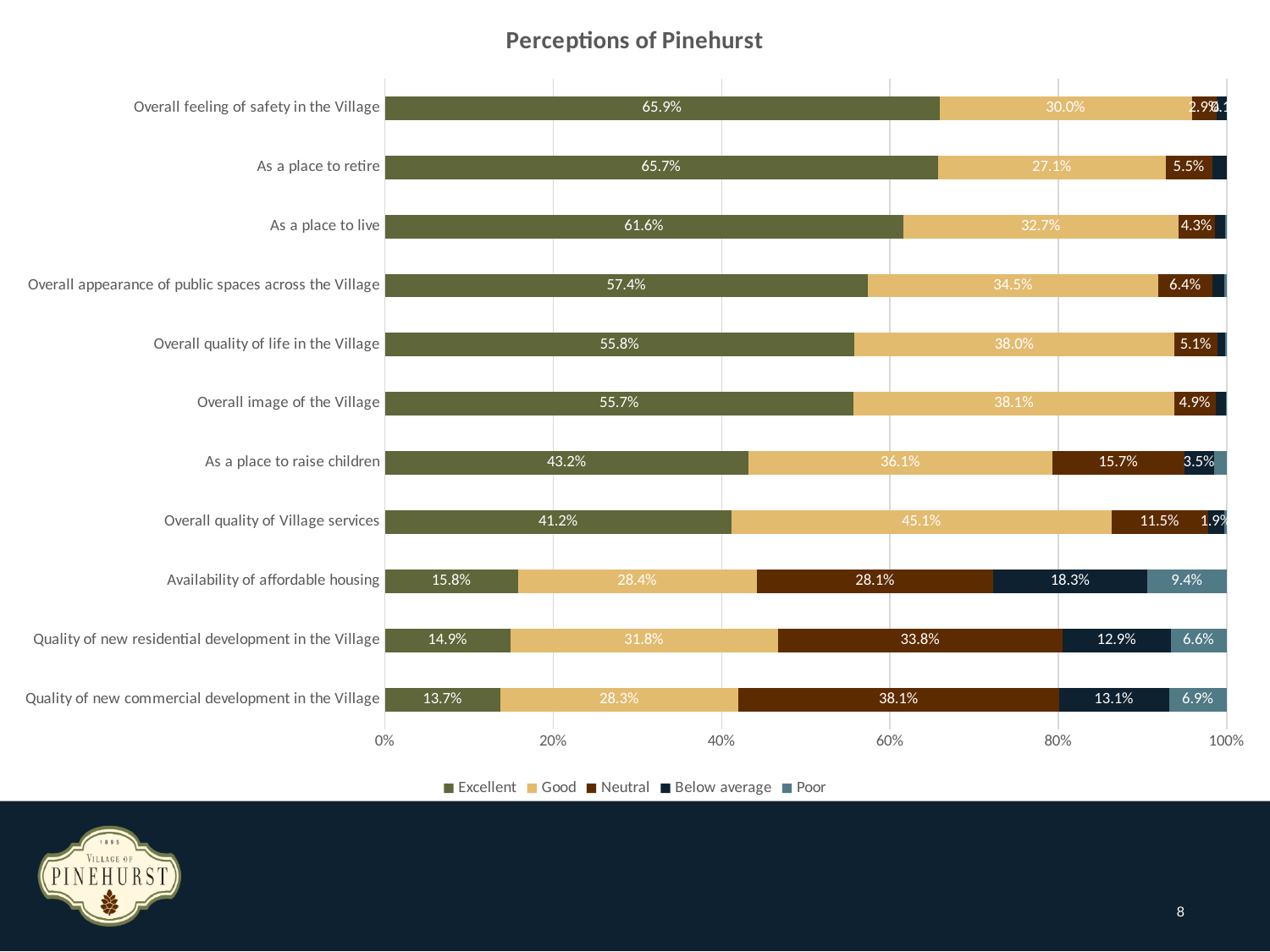
What kind of chart is shown on the slide? Stacked bar chart How many categories are plotted in the Perceptions of Pinehurst chart? 11 What is the Good value for 'Overall image of the Village'? 38.1% Which category has the lowest Excellent value? Quality of new commercial development in the Village What is the Poor value for 'Availability of affordable housing'? 9.4% What is the Excellent value for 'As a place to retire'? 65.7% How many series does the legend list? 5 Which category has the highest Excellent value? Overall feeling of safety in the Village What is the difference between the Good value for 'Overall quality of Village services' and the Good value for 'As a place to retire'? 18.0 percentage points What is the Neutral value for 'Quality of new commercial development in the Village'? 38.1% What is the first entry in the chart's legend? Excellent Which has the larger Neutral value: 'Availability of affordable housing' or 'Quality of new residential development in the Village'? Quality of new residential development in the Village